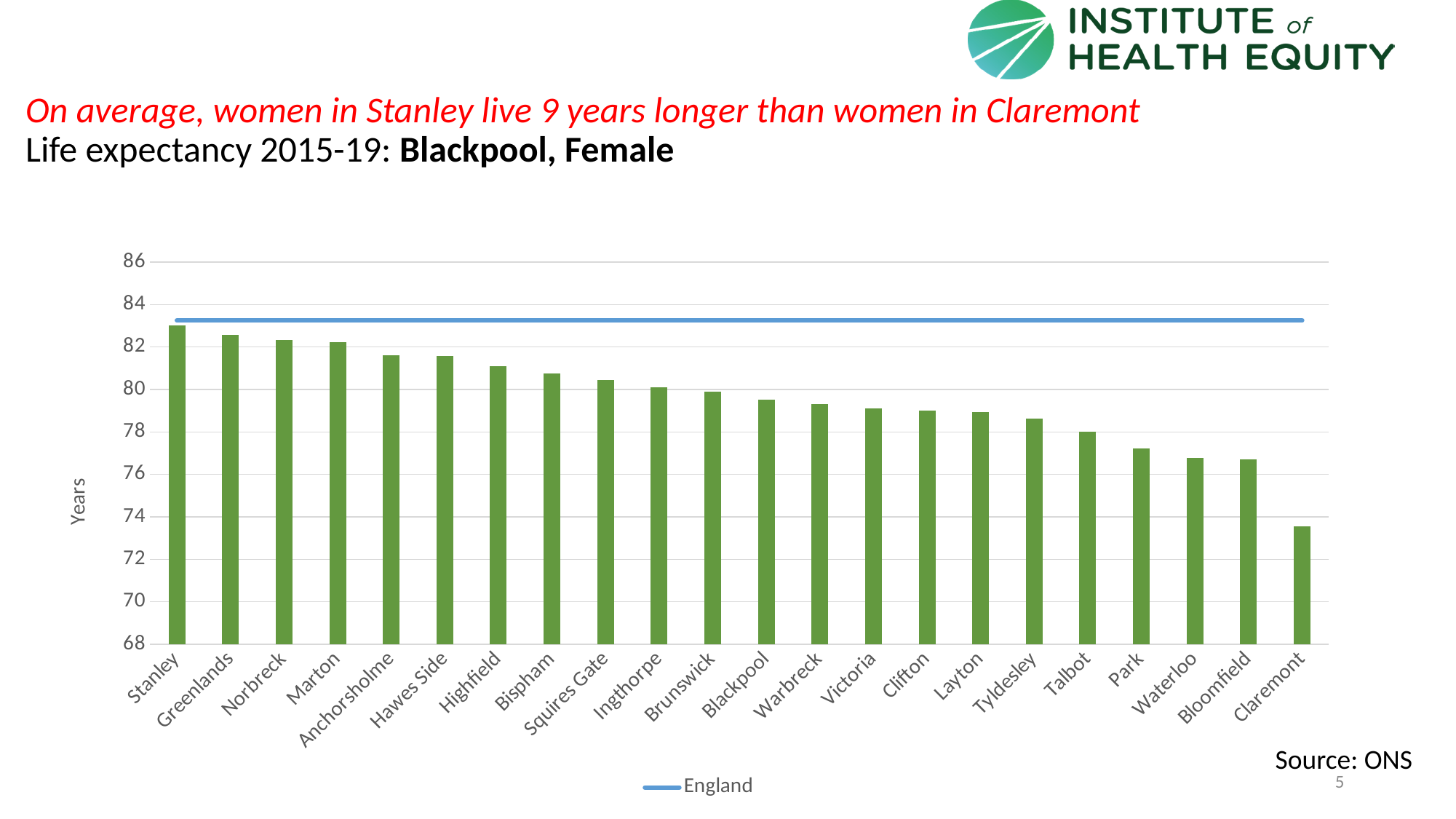
Which ward has the lowest female life expectancy in the chart? Claremont Is the value for Park greater or less than 78? less Do the bar values rise or fall moving from left to right along the x axis? fall How many entries does the chart legend list? 1 Which has the higher female life expectancy, Greenlands or Bloomfield? Greenlands Is the value for Bispham greater or less than 80? greater Is the value for Claremont greater or less than 74? less Which ward has the highest female life expectancy in the chart? Stanley What kind of chart is shown on the slide? combination bar and line chart (bars with a horizontal England line) What is the label on the vertical axis of the chart? Years How many wards (bars) are shown in the chart? 22